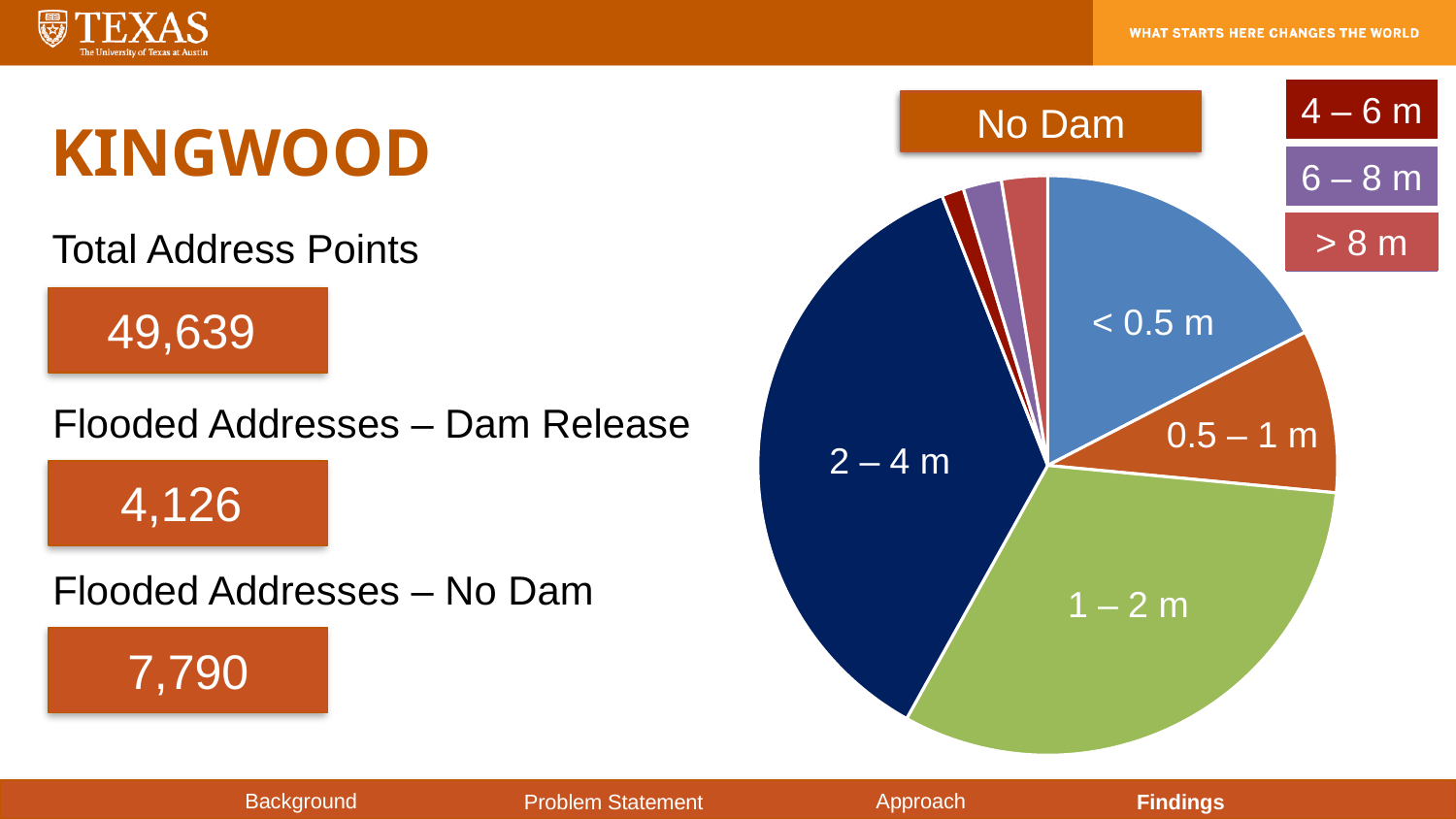
What is the title of the pie chart? No Dam Which slice is larger in the pie chart, 2 – 4 m or 1 – 2 m? 2 – 4 m Which slice is larger in the pie chart, 1 – 2 m or < 0.5 m? 1 – 2 m Which slice is larger in the pie chart, 0.5 – 1 m or 4 – 6 m? 0.5 – 1 m What colour is the 2 – 4 m slice in the pie chart? dark blue How many slices (flood depth categories) does the pie chart have? 7 What kind of chart is shown on the slide? pie chart Which flood depth category has the largest slice in the pie chart? 2 – 4 m Which flood depth category has the smallest slice in the pie chart? 4 – 6 m